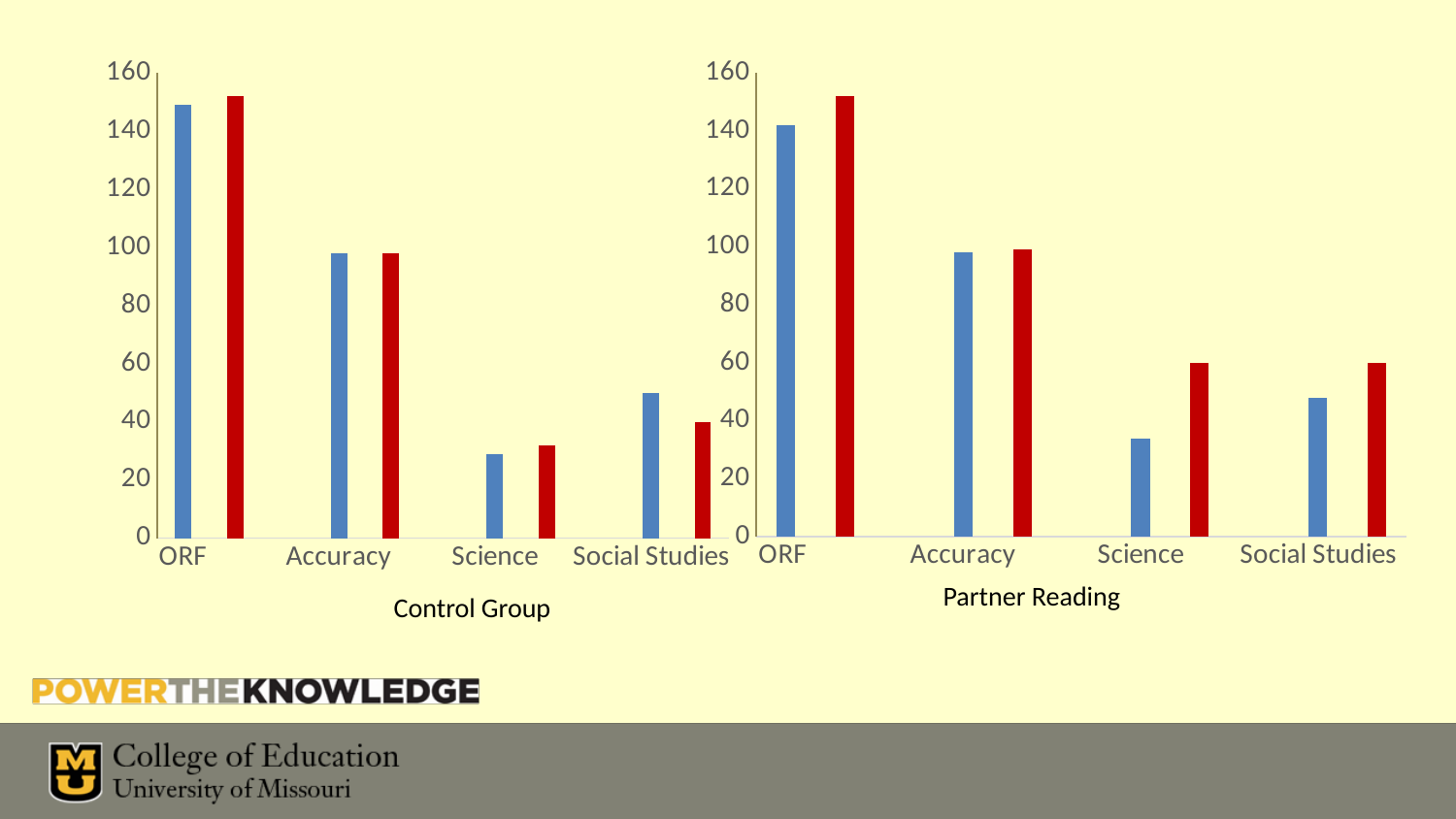
How many categories are shown on the x axis of the Partner Reading chart? 4 In the Control Group chart, which category has the lowest bars? Science In the Control Group chart, which is larger for Social Studies, the blue bar or the red bar? the blue bar In the Control Group chart, which category has the highest bars? ORF What is the title of the chart on the right side of the slide? Partner Reading In the Partner Reading chart, is the blue bar for ORF greater or less than 120? greater In the Partner Reading chart, which is larger for Science, the blue bar or the red bar? the red bar In the Control Group chart, is the red bar for Accuracy greater or less than 80? greater What kind of chart is the Control Group chart? bar chart In the Control Group chart, is the blue bar for Science greater or less than 40? less In the Partner Reading chart, which category has the highest bars? ORF